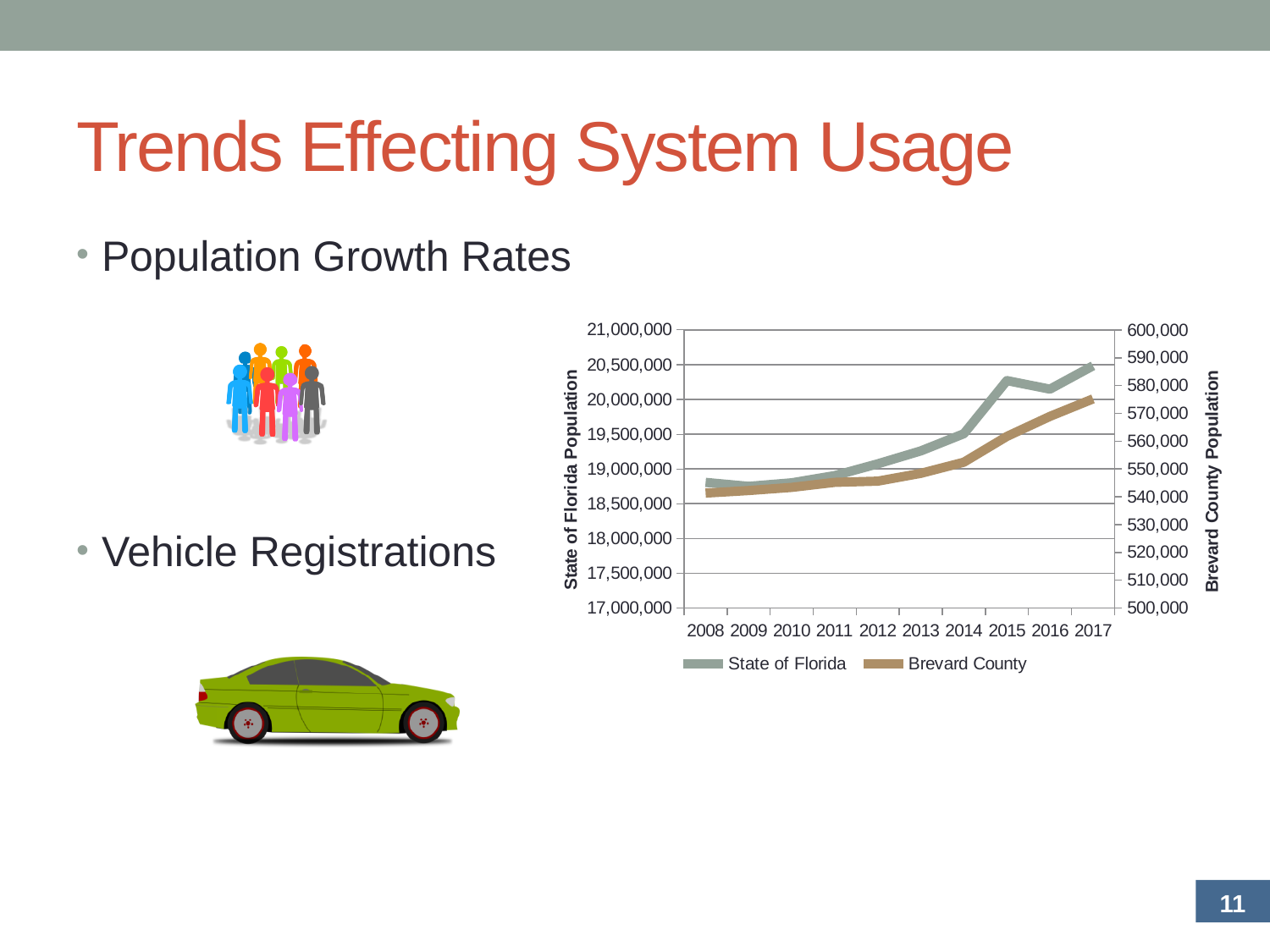
How many years are plotted along the x axis of the chart? 10 What kind of chart is shown on the slide? line chart Which series does the left vertical axis of the chart measure? State of Florida Population Is the State of Florida population in 2017 greater or less than 20,000,000? greater How many series does the chart's legend list? 2 Is the Brevard County population in 2017 greater or less than 560,000? greater Does the Brevard County population rise or fall from 2008 to 2017 in the chart? rise In which year is the State of Florida population highest in the chart? 2017 Does the State of Florida population rise or fall from 2008 to 2017 in the chart? rise Is the State of Florida population in 2008 greater or less than 19,000,000? less In which year is the Brevard County population highest in the chart? 2017 What is the label on the right vertical axis of the chart? Brevard County Population